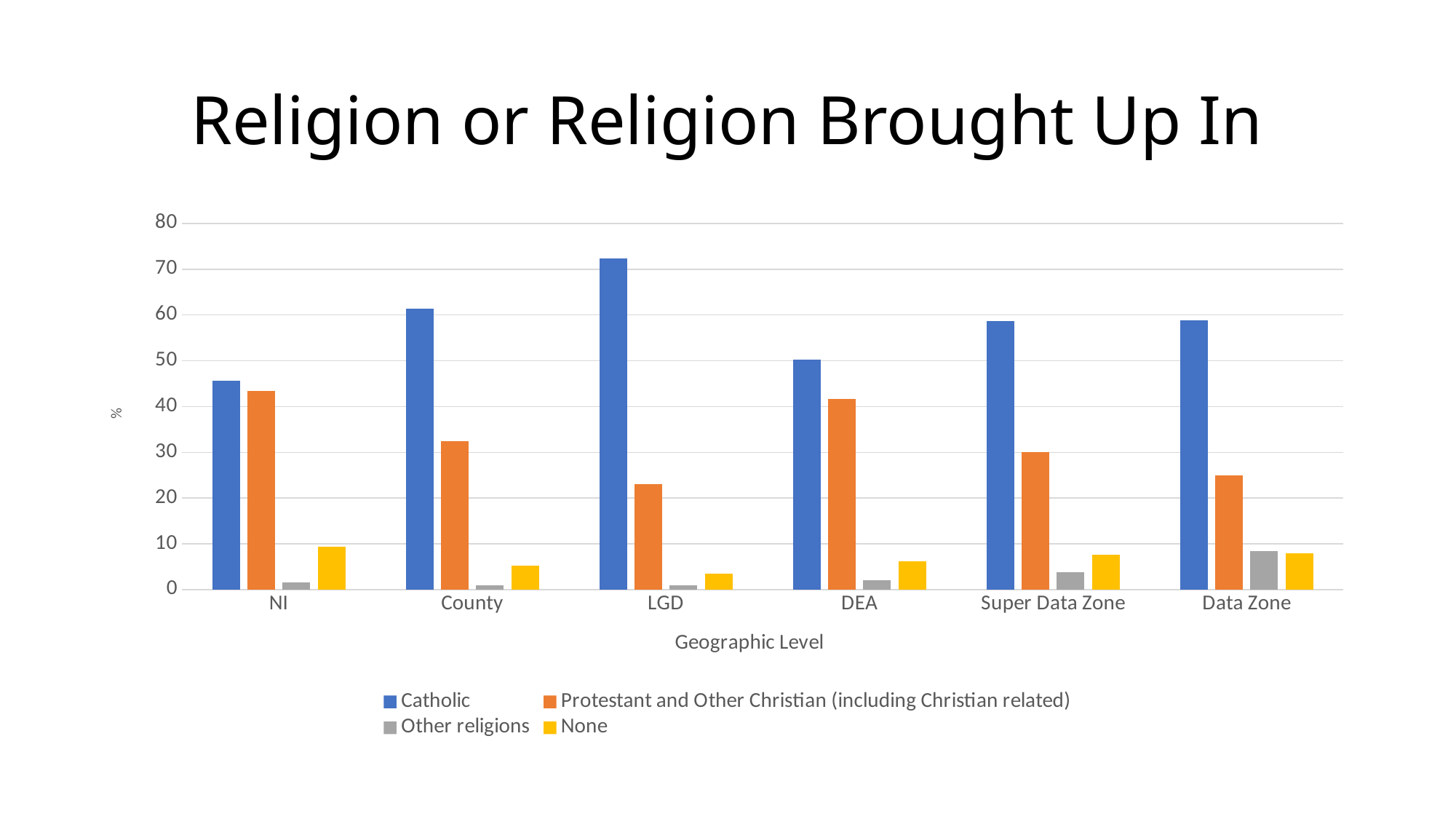
Which is larger at LGD, the Catholic value or the Protestant and Other Christian (including Christian related) value? Catholic At which geographic level is the Protestant and Other Christian (including Christian related) value lowest? LGD How many series does the legend list? 4 What is the label of the x axis? Geographic Level At which geographic level is the Catholic value highest? LGD At which geographic level is the Protestant and Other Christian (including Christian related) value highest? NI At which geographic level is the Catholic value lowest? NI Is the Catholic value for LGD greater or less than 70? greater How many geographic levels are shown on the x axis? 6 What type of chart is shown on the slide? bar chart At which geographic level is the Other religions value highest? Data Zone Is the Protestant and Other Christian (including Christian related) value for LGD greater or less than 30? less